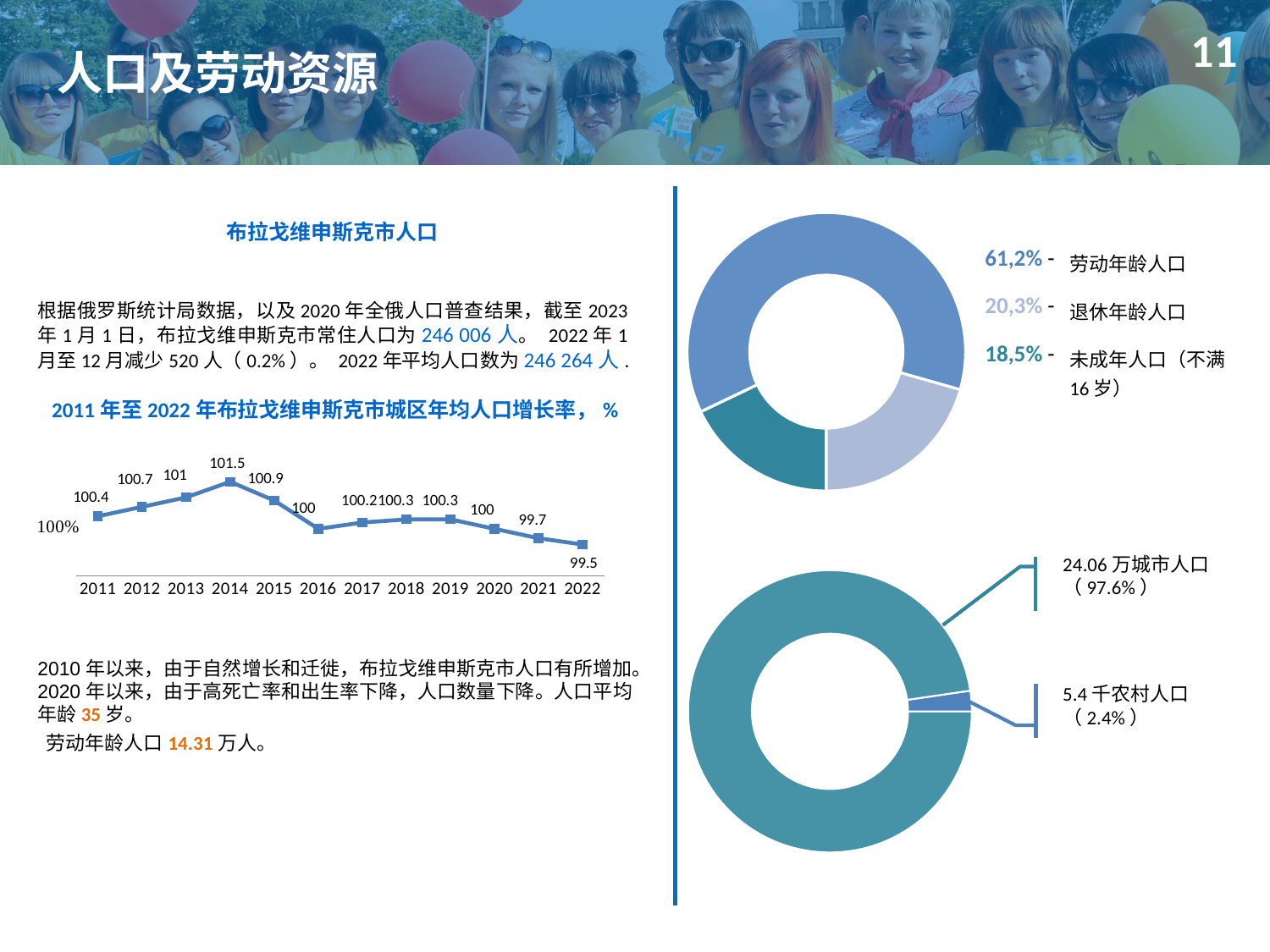
In the lower donut chart on the right side of the slide, what share is 农村人口? 2.4% In the line chart titled "2011 年至 2022 年布拉戈维申斯克市城区年均人口增长率，%", what is the difference between the values for 2014 and 2022? 2 In the line chart titled "2011 年至 2022 年布拉戈维申斯克市城区年均人口增长率，%", do the values rise or fall from 2019 to 2022? fall In the line chart titled "2011 年至 2022 年布拉戈维申斯克市城区年均人口增长率，%", what is the value for 2022? 99.5 In the line chart titled "2011 年至 2022 年布拉戈维申斯克市城区年均人口增长率，%", which year has the lowest value? 2022 In the line chart titled "2011 年至 2022 年布拉戈维申斯克市城区年均人口增长率，%", which is larger, the value for 2012 or the value for 2021? 2012 In the line chart titled "2011 年至 2022 年布拉戈维申斯克市城区年均人口增长率，%", which year has the highest value? 2014 In the line chart titled "2011 年至 2022 年布拉戈维申斯克市城区年均人口增长率，%", what is the value for 2014? 101.5 In the upper donut chart on the right side of the slide, what share is 劳动年龄人口? 61,2% What kind of chart is the chart titled "2011 年至 2022 年布拉戈维申斯克市城区年均人口增长率，%"? line chart In the upper donut chart on the right side of the slide, which category has the smallest share? 未成年人口（不满 16 岁） How many years are plotted in the line chart titled "2011 年至 2022 年布拉戈维申斯克市城区年均人口增长率，%"? 12